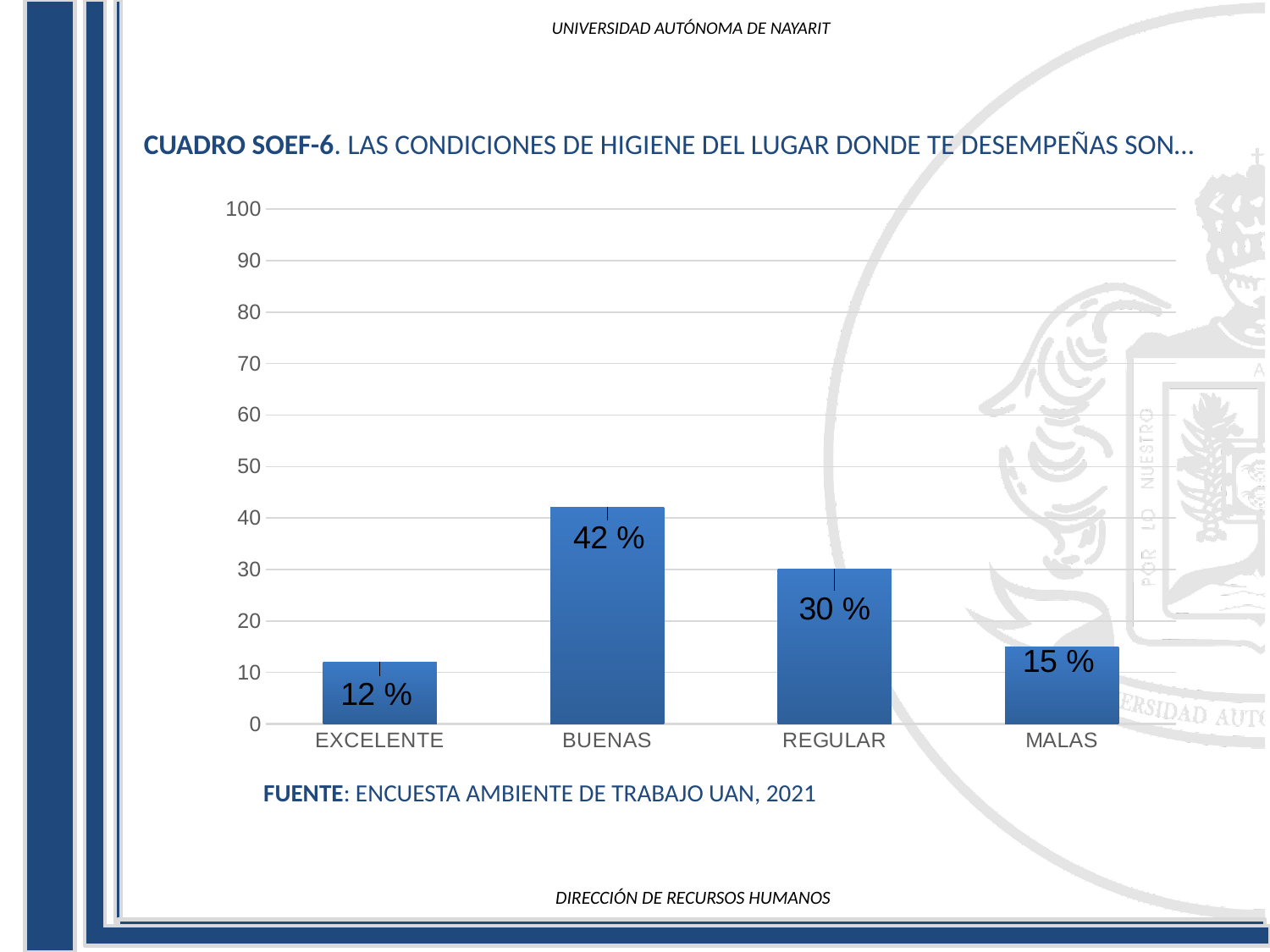
What kind of chart is shown on the slide? bar chart What is the value for REGULAR? 30 % Which category has the lowest value? EXCELENTE Which is larger, the value for REGULAR or the value for MALAS? REGULAR What is the value for EXCELENTE? 12 % Is the value for BUENAS greater or less than 40? greater What is the value for MALAS? 15 % Which category has the highest value? BUENAS What is the difference between the values for BUENAS and REGULAR? 12 % How many categories are shown on the x axis? 4 What is the difference between the values for MALAS and EXCELENTE? 3 % What is the value for BUENAS? 42 %